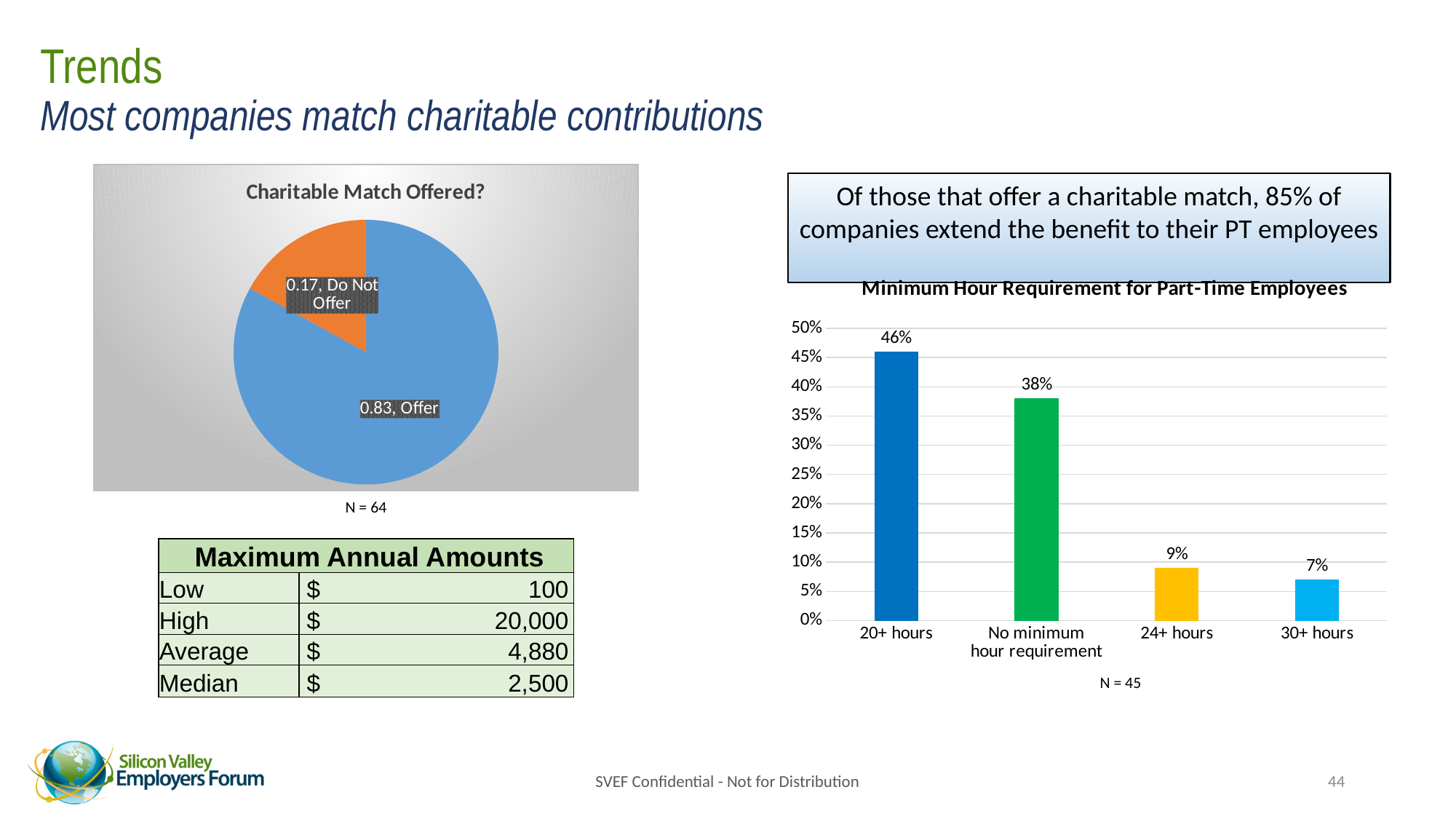
In the 'Charitable Match Offered?' chart, what value is shown for the 'Offer' slice? 0.83 In the 'Charitable Match Offered?' chart, what kind of chart is shown? pie chart In the 'Charitable Match Offered?' chart, which slice is larger, 'Offer' or 'Do Not Offer'? Offer In the 'Minimum Hour Requirement for Part-Time Employees' chart, what is the difference between the values for '20+ hours' and 'No minimum hour requirement'? 8% In the 'Minimum Hour Requirement for Part-Time Employees' chart, what kind of chart is shown? bar chart In the 'Minimum Hour Requirement for Part-Time Employees' chart, what is the value for 'No minimum hour requirement'? 38% In the 'Minimum Hour Requirement for Part-Time Employees' chart, which category has the highest value? 20+ hours In the 'Charitable Match Offered?' chart, what value is shown for the 'Do Not Offer' slice? 0.17 In the 'Minimum Hour Requirement for Part-Time Employees' chart, how many categories are shown on the x axis? 4 In the 'Charitable Match Offered?' chart, how many slices does the pie have? 2 In the 'Minimum Hour Requirement for Part-Time Employees' chart, what is the value for '20+ hours'? 46% In the 'Minimum Hour Requirement for Part-Time Employees' chart, which category has the lowest value? 30+ hours